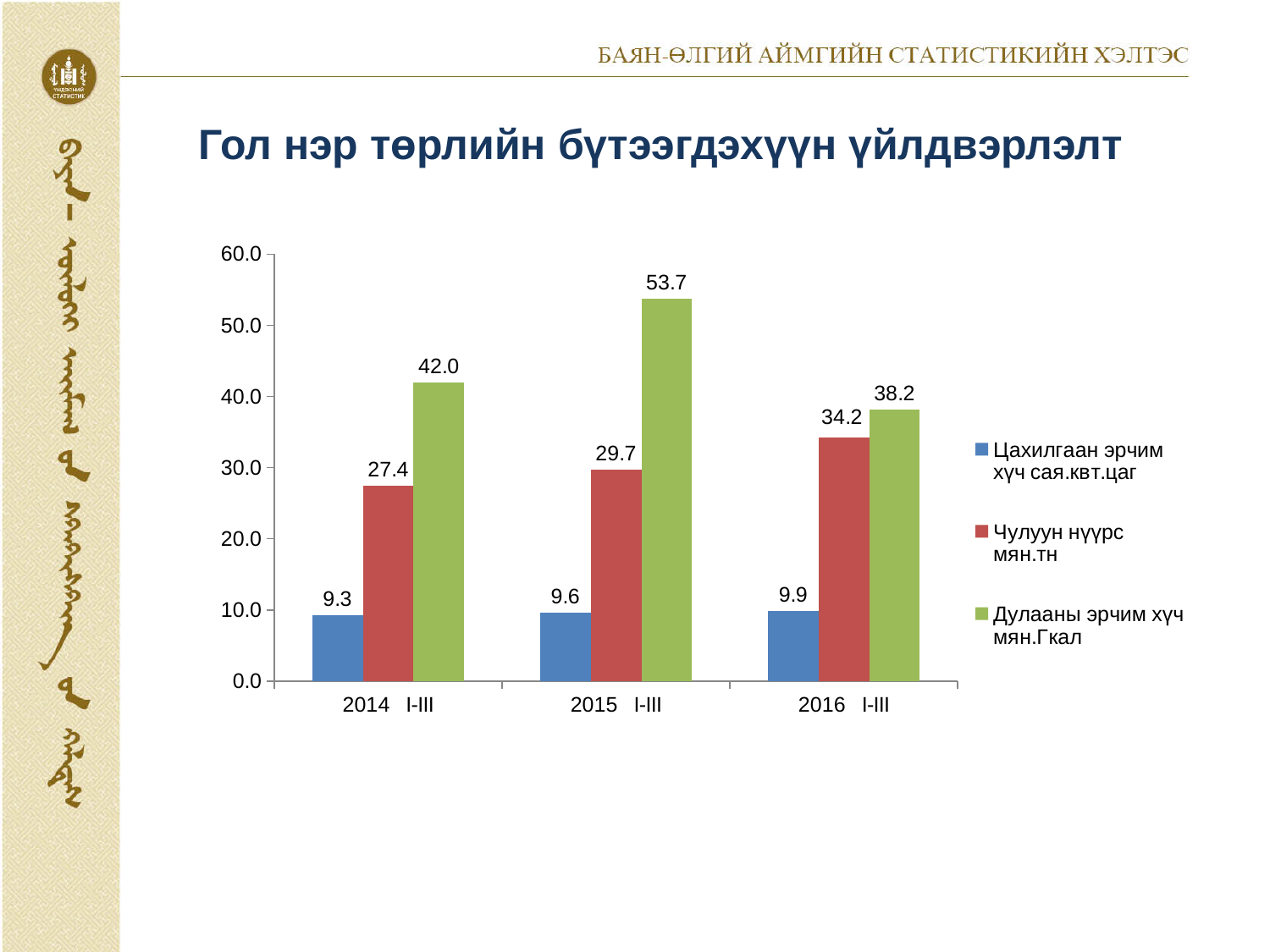
In which period is Дулааны эрчим хүч мян.Гкал highest? 2015 I-III How many periods are shown on the x axis? 3 Does Чулуун нүүрс мян.тн rise or fall from 2014 I-III to 2016 I-III? rise What is the value of Цахилгаан эрчим хүч сая.квт.цаг for 2014 I-III? 9.3 What is the value of Дулааны эрчим хүч мян.Гкал for 2016 I-III? 38.2 In which period is Чулуун нүүрс мян.тн lowest? 2014 I-III What is the value of Чулуун нүүрс мян.тн for 2015 I-III? 29.7 Which is larger in 2016 I-III: Чулуун нүүрс мян.тн or Дулааны эрчим хүч мян.Гкал? Дулааны эрчим хүч мян.Гкал What kind of chart is shown on the slide? bar chart What is the difference between Дулааны эрчим хүч мян.Гкал in 2015 I-III and 2014 I-III? 11.7 How many series does the legend list? 3 Is the value of Дулааны эрчим хүч мян.Гкал for 2015 I-III greater or less than 50.0? greater